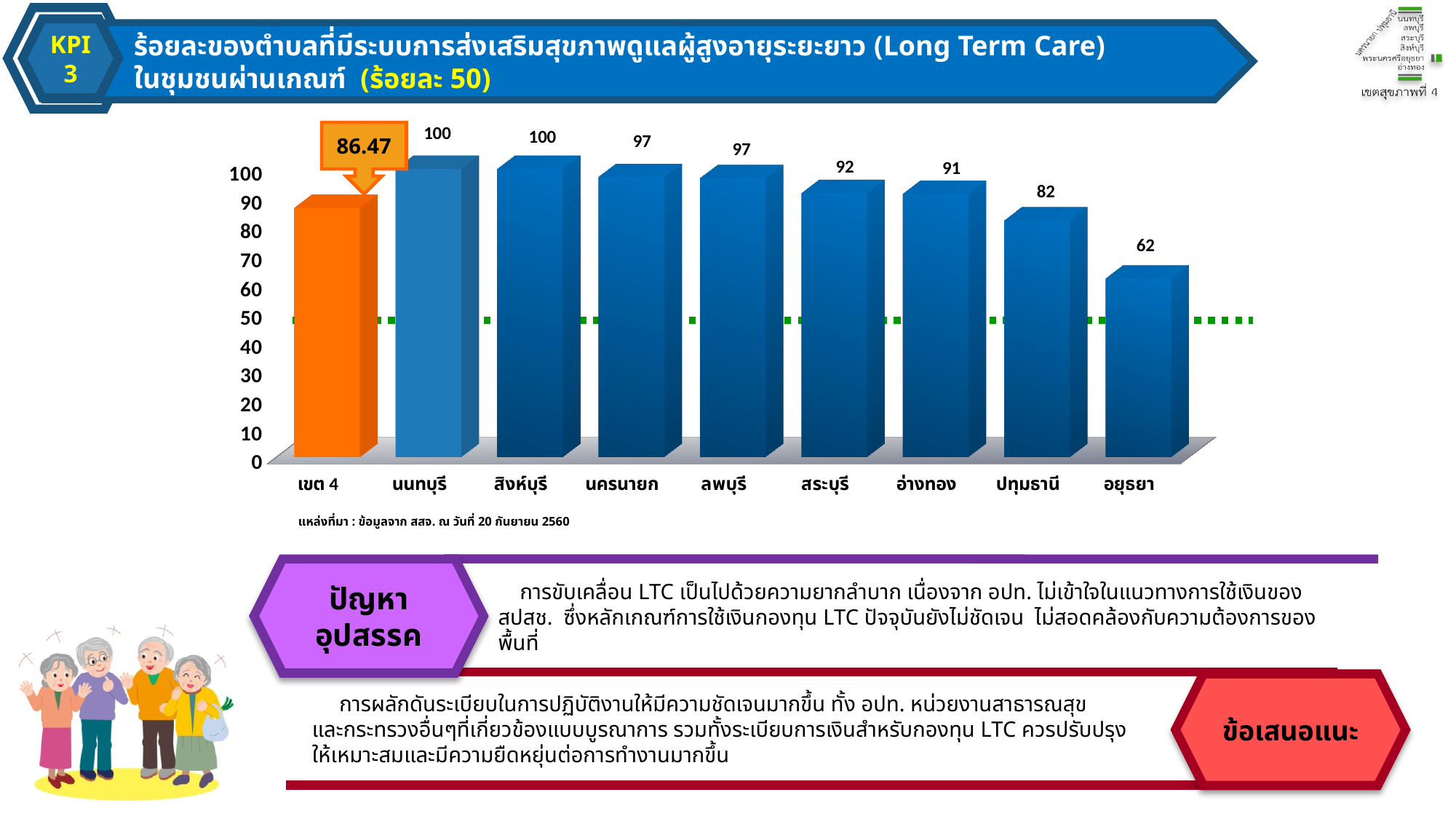
Is the value for อยุธยา greater or less than 50? greater Which is larger, the value for สระบุรี or the value for ปทุมธานี? สระบุรี What is the value for เขต 4? 86.47 At what value is the green dotted target line drawn? 50 How many categories are shown on the x axis? 9 What is the value for สระบุรี? 92 What is the value for อยุธยา? 62 Which category has the lowest value? อยุธยา What is the difference between the values for อ่างทอง and ปทุมธานี? 9 What is the difference between the values for นนทบุรี and อยุธยา? 38 What kind of chart is shown on the slide? bar chart What is the value for ปทุมธานี? 82